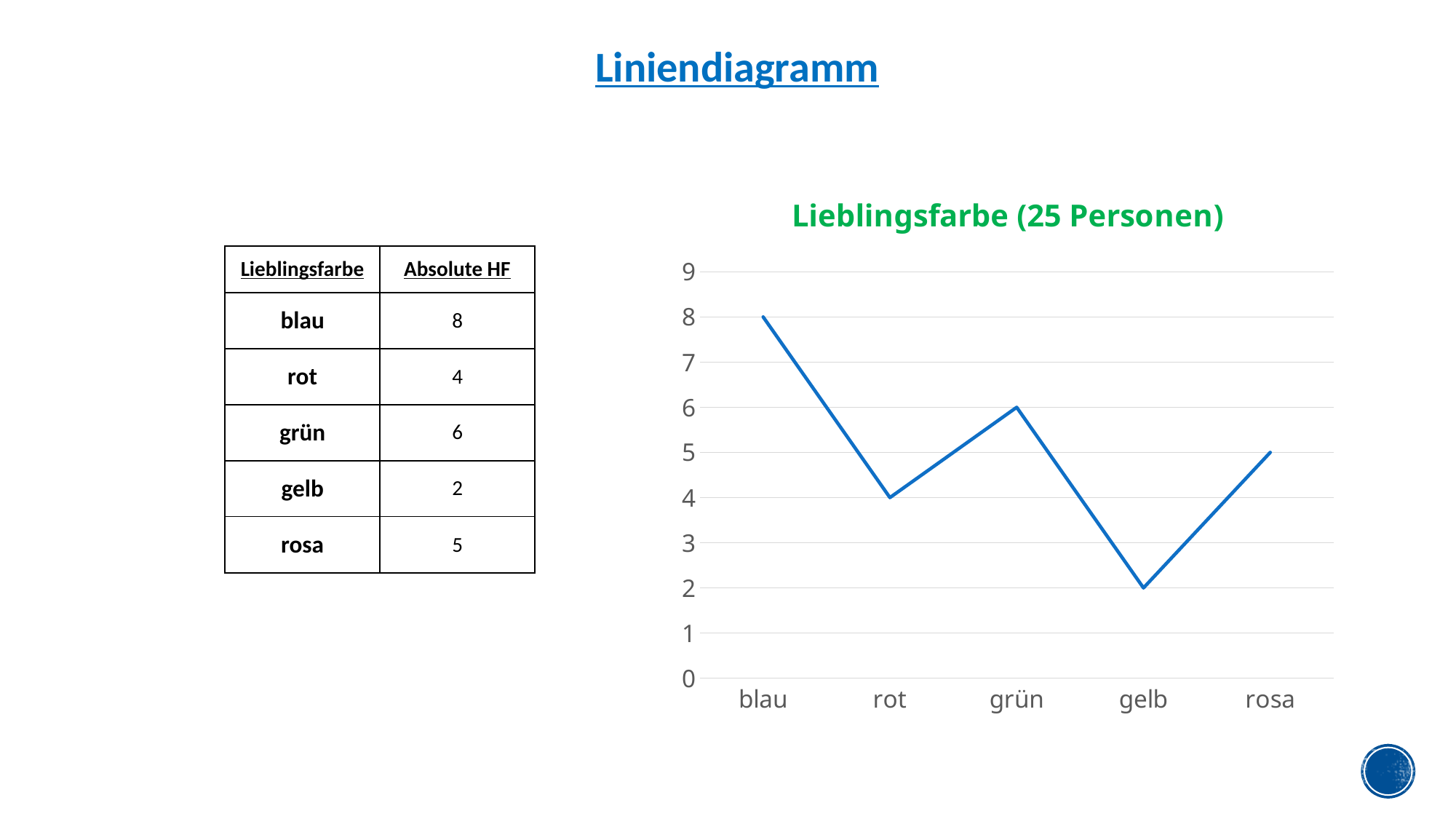
What kind of chart is shown on the slide? line chart What is the value for rosa in the chart? 5 Which has a larger value, grün or rosa? grün Which category has the highest value in the chart? blau What is the value for blau in the chart? 8 What is the difference between the values for blau and rot? 4 What is the title of the chart? Lieblingsfarbe (25 Personen) Is the value for rot greater or less than 5? less How many categories are shown on the x axis of the chart? 5 Does the line rise or fall from blau to rot? fall What is the value for gelb in the chart? 2 Which category has the lowest value in the chart? gelb